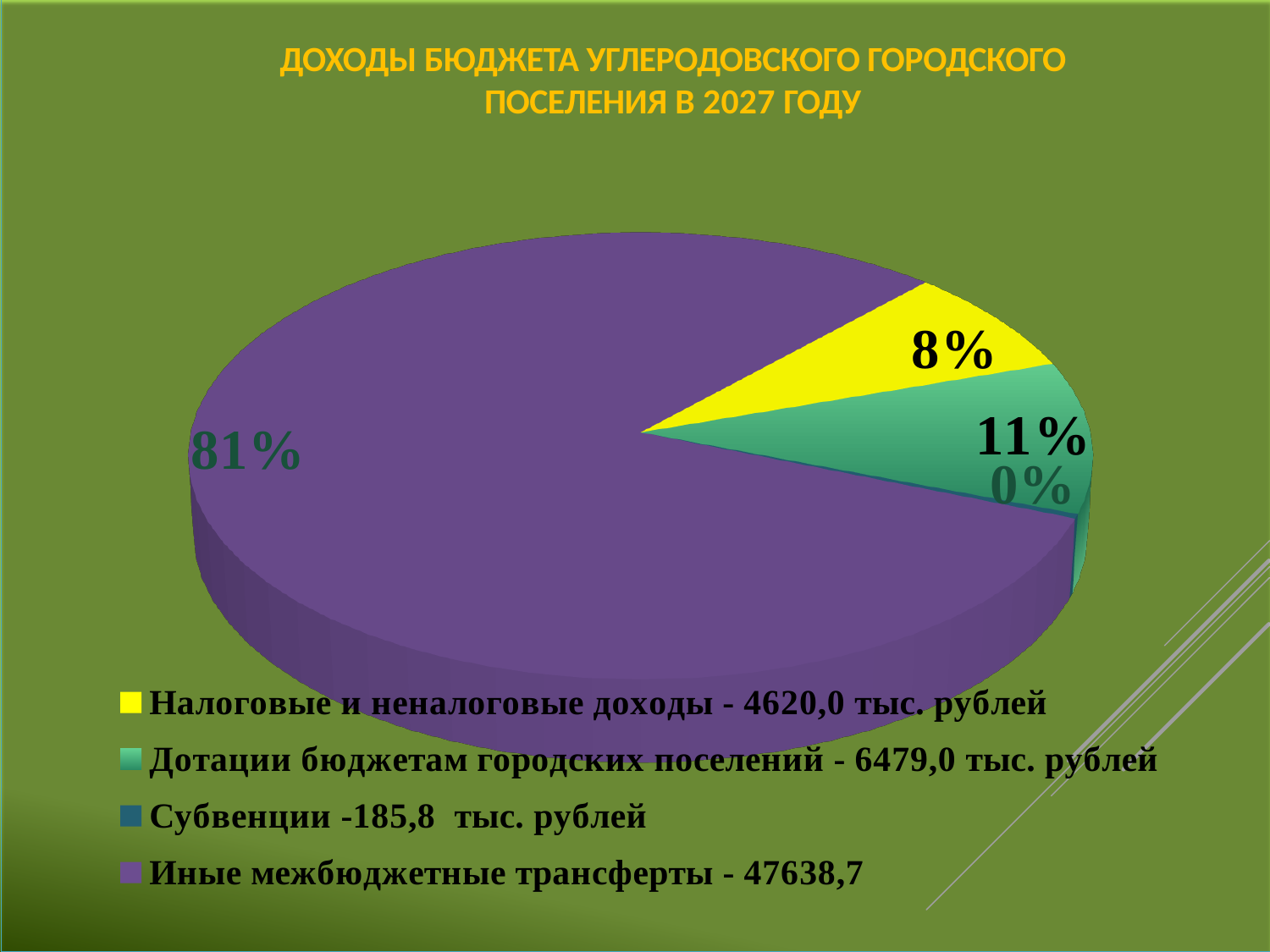
What share of the pie does the slice for Дотации бюджетам городских поселений have? 11% What colour is the slice for Налоговые и неналоговые доходы? yellow What share of the pie does the slice for Налоговые и неналоговые доходы have? 8% Which slice is larger: Дотации бюджетам городских поселений or Налоговые и неналоговые доходы? Дотации бюджетам городских поселений What share of the pie does the slice for Субвенции have? 0% What is the difference in percentage points between the share for Иные межбюджетные трансферты and the share for Дотации бюджетам городских поселений? 70 percentage points What kind of chart is shown on the slide? pie chart How many categories does the legend list? 4 What amount is given in the legend for Субвенции? 185,8 тыс. рублей Which category has the smallest slice of the pie? Субвенции Which category has the largest slice of the pie? Иные межбюджетные трансферты